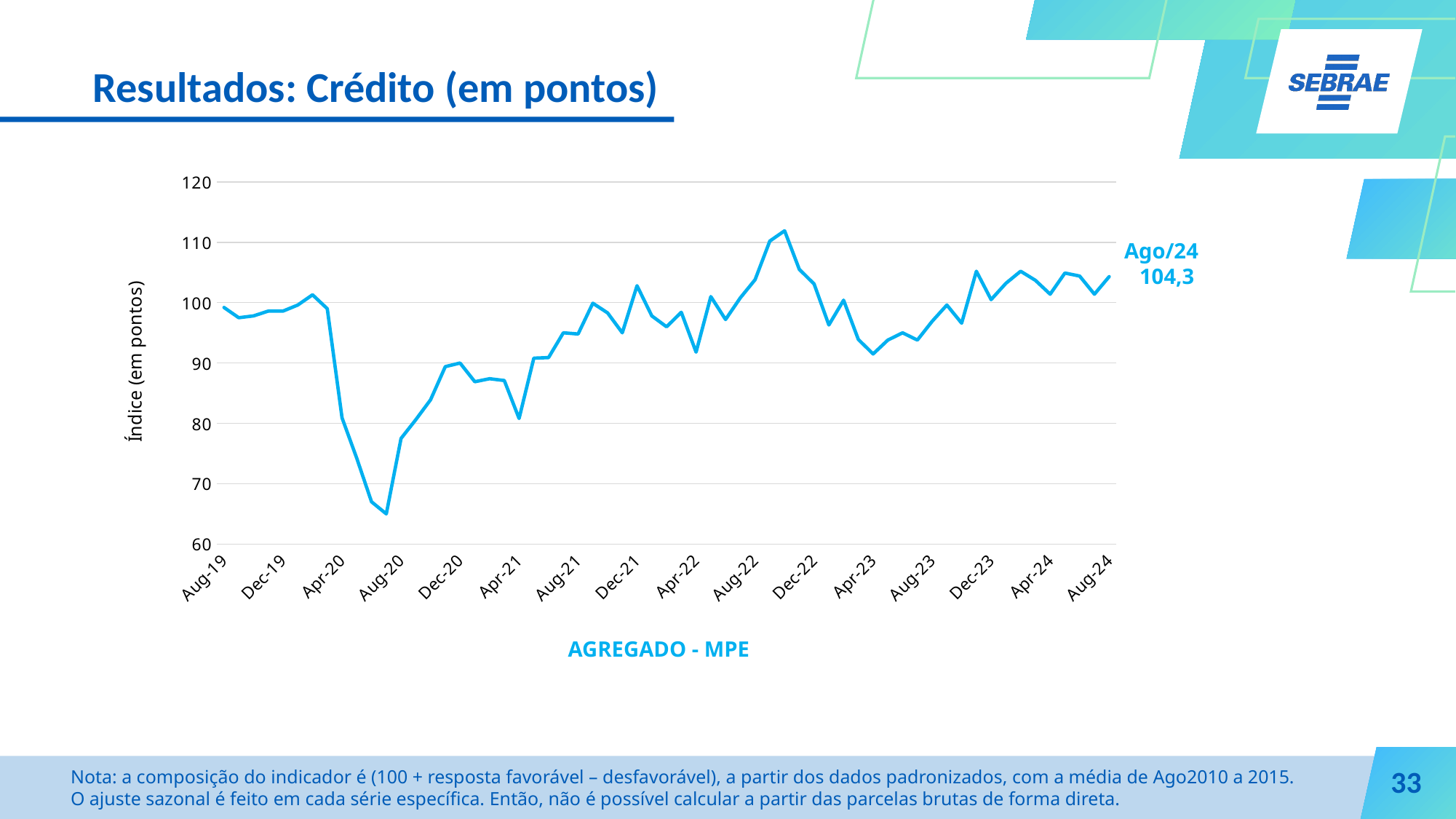
Is the value for Apr-23 greater or less than 100? less How many series does the legend list? 1 Is the value for Dec-19 greater or less than 90? greater Which labelled month on the x axis has the lowest value of the index? Aug-20 What is the value of the AGREGADO - MPE index for Aug-24 (Ago/24)? 104,3 Does the index rise or fall between Apr-20 and Aug-20? fall Is the value for Aug-20 greater or less than 70? greater What is the title of the y axis? Índice (em pontos) How many month labels are shown on the x axis? 16 Which is larger, the value for Aug-19 or the value for Aug-20? Aug-19 What kind of chart is shown on the slide? line chart